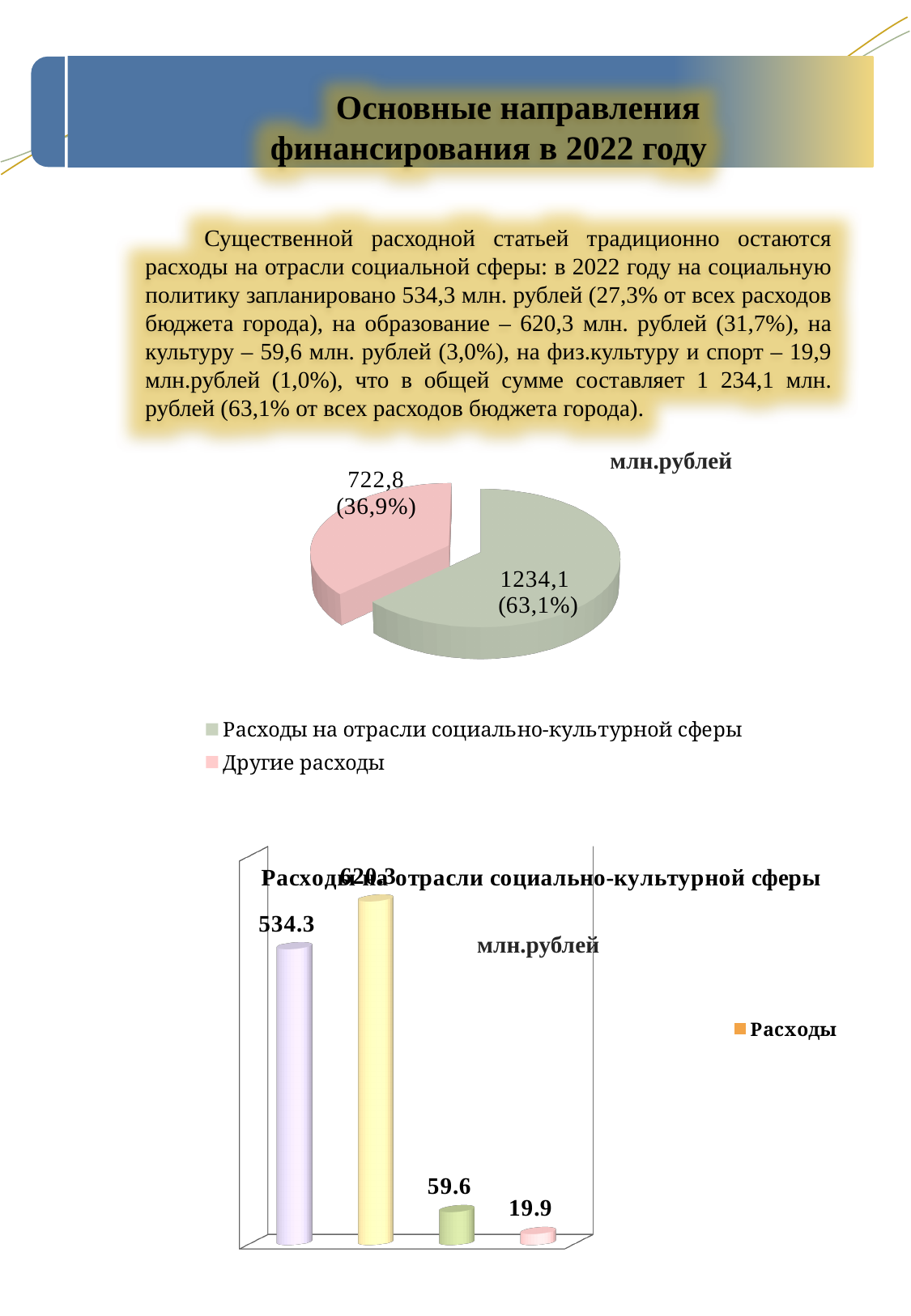
How many slices does the pie chart have? 2 In the pie chart, what share of the total does 'Расходы на отрасли социально-культурной сферы' represent? 63,1% What kind of chart is the top chart on the slide? Pie chart In the bottom bar chart, what is the highest value shown? 620.3 In the pie chart, which slice is larger: 'Расходы на отрасли социально-культурной сферы' or 'Другие расходы'? Расходы на отрасли социально-культурной сферы How many bars are in the bottom bar chart 'Расходы на отрасли социально-культурной сферы'? 4 In the pie chart, what value is shown for 'Другие расходы'? 722,8 In the bottom bar chart, what is the lowest value shown? 19.9 In the pie chart, what share of the total does 'Другие расходы' represent? 36,9% In the pie chart, what value is shown for 'Расходы на отрасли социально-культурной сферы'? 1234,1 What kind of chart is the bottom chart on the slide? Bar chart In the bottom bar chart, what is the difference between the second bar (620.3) and the first bar (534.3)? 86.0